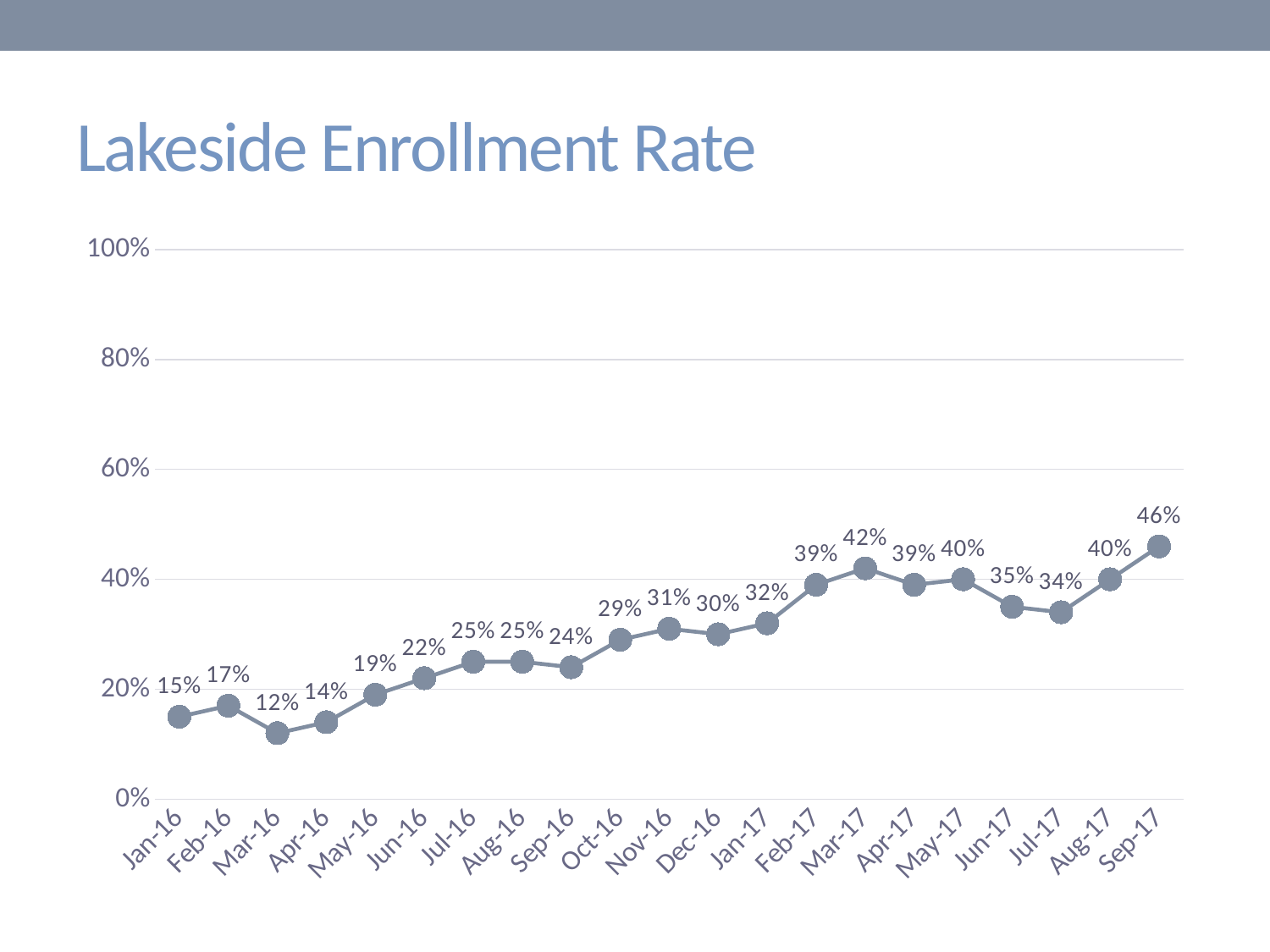
Which month has the highest enrollment rate? Sep-17 What is the enrollment rate for Jun-17? 35% How many months are plotted on the chart? 21 Which month has the lowest enrollment rate? Mar-16 Does the enrollment rate generally rise or fall from Jan-16 to Sep-17? rise What is the difference between the enrollment rate in Mar-17 and in Jul-17? 8% What is the enrollment rate for Mar-17? 42% Is the enrollment rate for Oct-16 greater or less than 20%? greater Which is larger, the enrollment rate for Feb-17 or for Jun-17? Feb-17 What is the enrollment rate for Jan-16? 15% What kind of chart is shown on the slide? line chart What is the difference between the enrollment rate in Sep-17 and in Jan-16? 31%